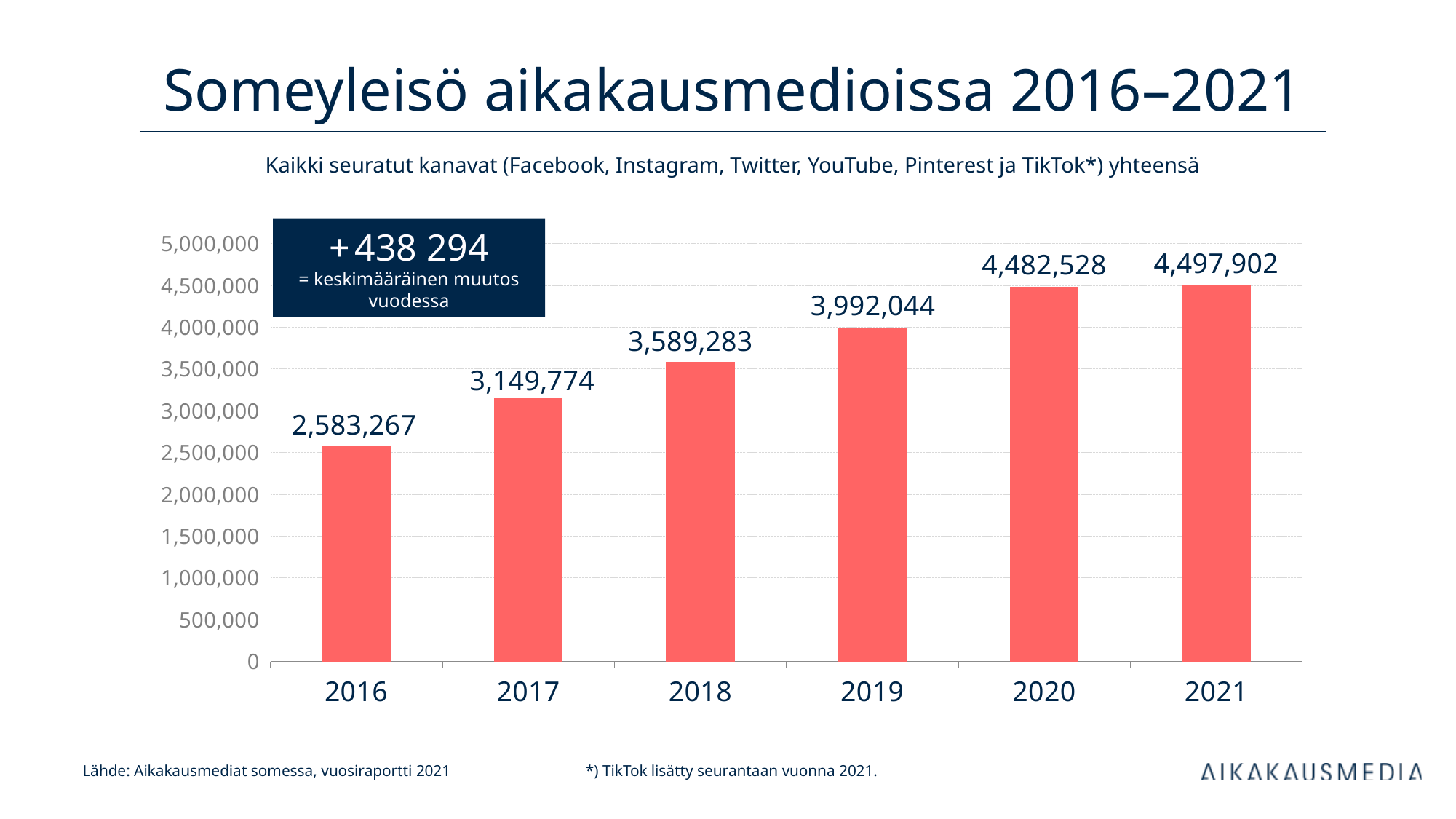
Which year has the lowest value? 2016 Which is larger, the value for 2020 or the value for 2021? 2021 Which year has the highest value? 2021 Do the values rise or fall from 2016 to 2021? rise What kind of chart is shown on the slide? bar chart How many years are shown on the x axis? 6 What is the value for 2019? 3,992,044 What is the difference between the values for 2017 and 2016? 566,507 What is the difference between the values for 2021 and 2016? 1,914,635 What is the value for 2016? 2,583,267 Is the value for 2018 greater or less than 3,500,000? greater What is the value for 2021? 4,497,902